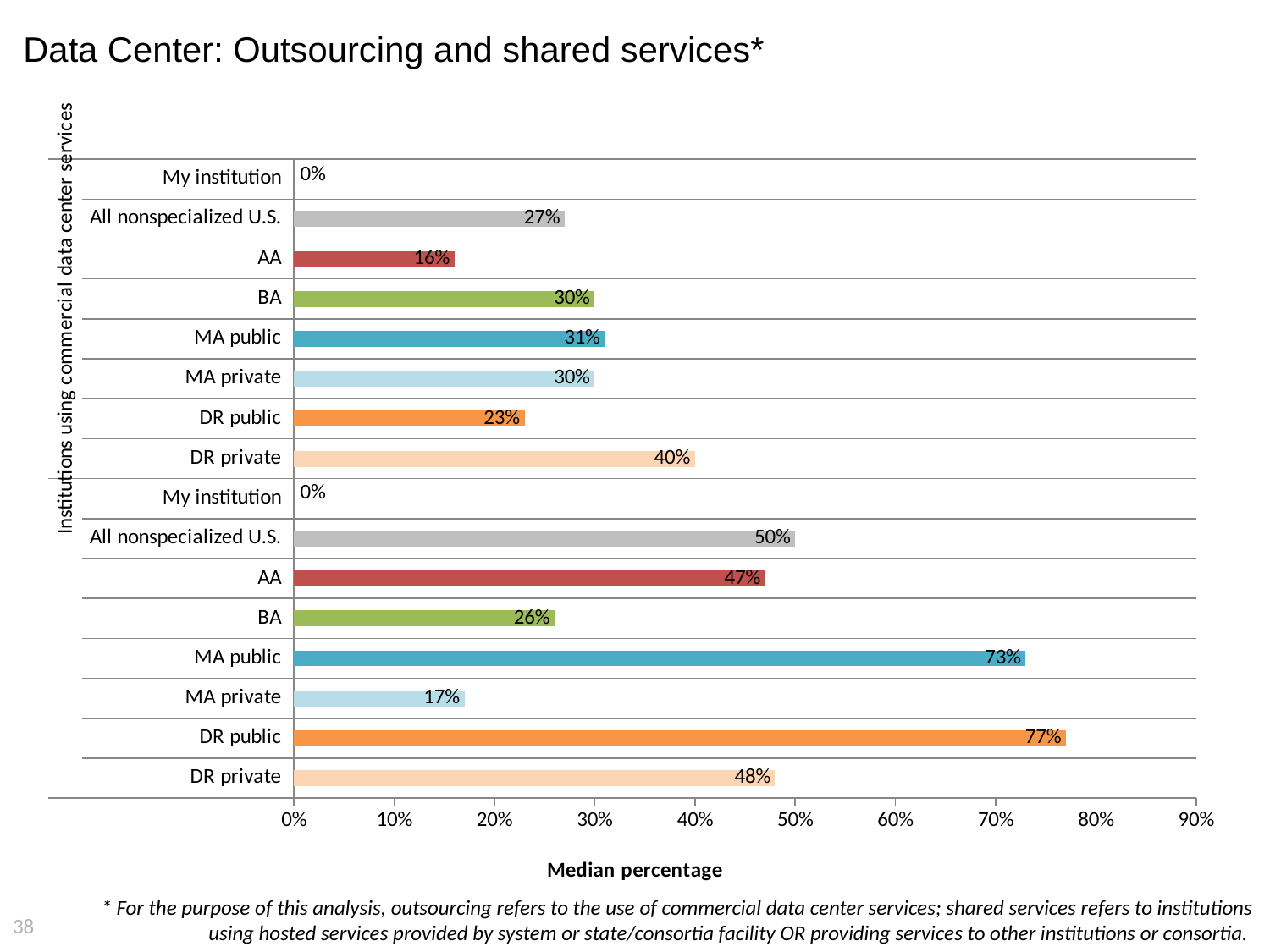
Which category has the lowest value in the lower group of bars? My institution In the upper group of bars, which is larger: AA or DR public? DR public How many bars (category rows) are shown on the chart in total? 16 What is the title of the horizontal axis? Median percentage In the lower group of bars, what is the difference between DR public and MA private? 60% Which category has the highest value in the upper group of bars? DR private Is the value for AA in the lower group of bars greater or less than 40%? greater Which category has the highest value in the lower group of bars? DR public What kind of chart is shown on the slide? Bar chart What is the value for DR private in the upper group of bars? 40% What is the value for MA public in the lower group of bars? 73% What is the value for AA in the upper group of bars? 16%